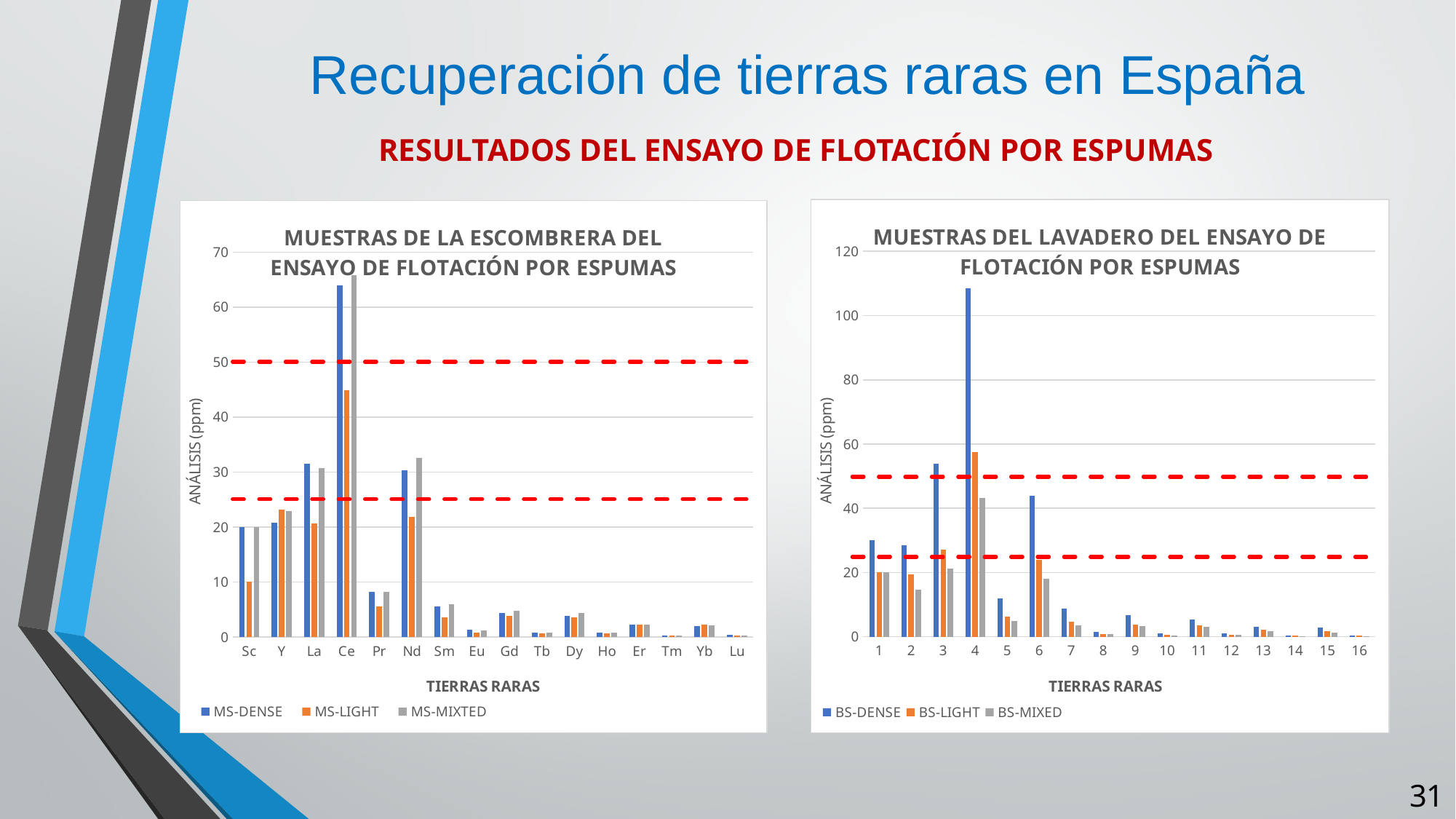
In the right chart (MUESTRAS DEL LAVADERO), is the BS-DENSE value for category 4 greater or less than 100? greater In the right chart (MUESTRAS DEL LAVADERO), which is larger for category 6: BS-DENSE or BS-LIGHT? BS-DENSE In the right chart (MUESTRAS DEL LAVADERO), which category has the highest BS-DENSE value? 4 What kind of chart is the left chart, 'MUESTRAS DE LA ESCOMBRERA DEL ENSAYO DE FLOTACIÓN POR ESPUMAS'? Bar chart In the left chart (MUESTRAS DE LA ESCOMBRERA), is the MS-DENSE value for Ce greater or less than 60? greater In the left chart (MUESTRAS DE LA ESCOMBRERA), which is larger for Sc: MS-DENSE or MS-LIGHT? MS-DENSE How many categories are shown on the x axis of the left chart (MUESTRAS DE LA ESCOMBRERA)? 16 How many series does the legend of the right chart (MUESTRAS DEL LAVADERO) list? 3 How many series does the legend of the left chart (MUESTRAS DE LA ESCOMBRERA) list? 3 In the left chart (MUESTRAS DE LA ESCOMBRERA), is the MS-LIGHT value for Ce greater or less than 50? less What is the y-axis title of the left chart (MUESTRAS DE LA ESCOMBRERA)? ANÁLISIS (ppm) In the left chart (MUESTRAS DE LA ESCOMBRERA), which category has the highest MS-DENSE value? Ce